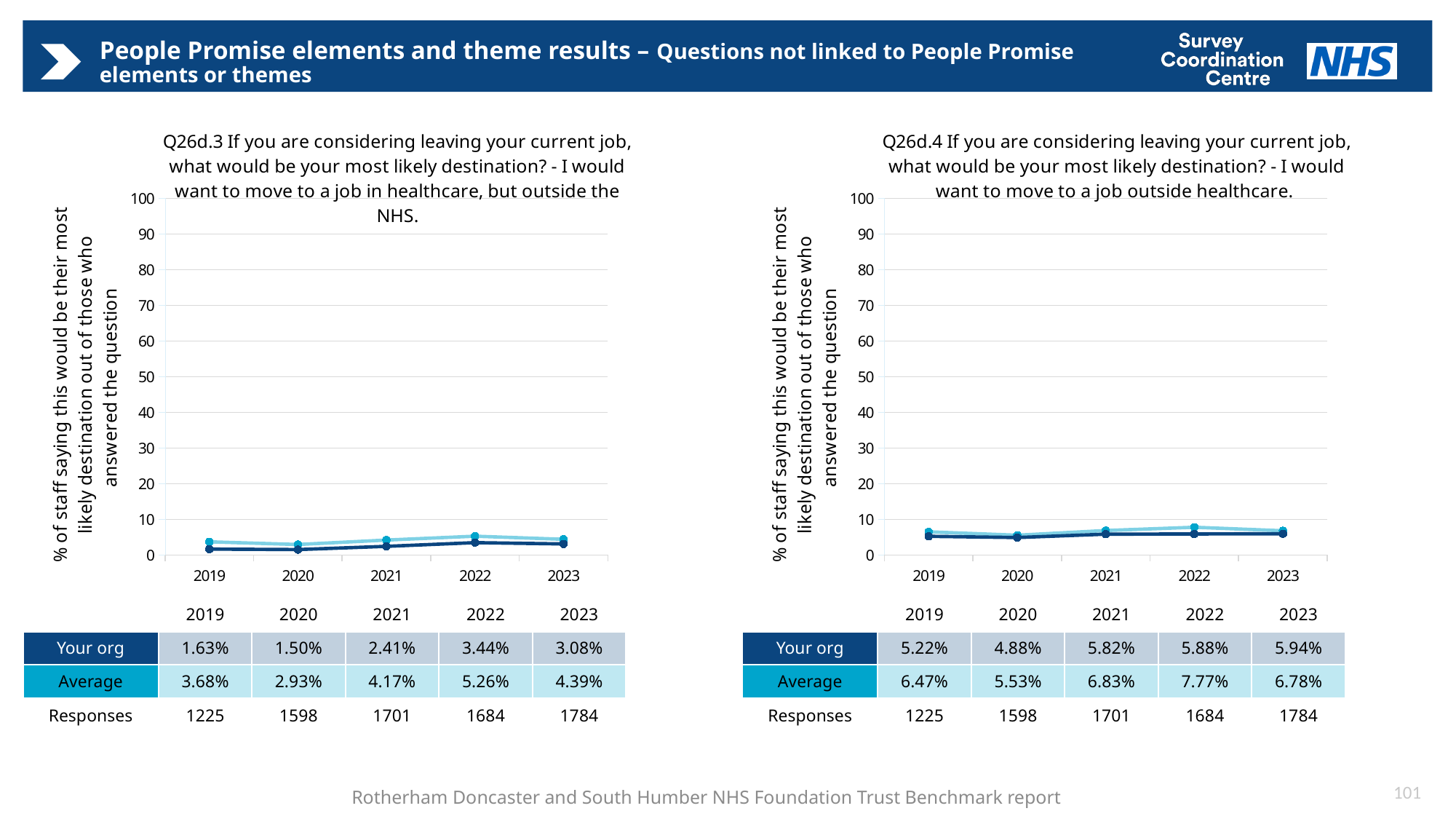
In the Q26d.4 chart (right), what is the Average value for 2020? 5.53% In the Q26d.3 chart (left), what is the Your org value for 2022? 3.44% How many years are plotted on the x axis of the Q26d.3 chart (left)? 5 In the Q26d.3 chart (left), how many responses were recorded for 2023? 1784 In the Q26d.4 chart (right), which year has the lowest Average value? 2020 What type of chart is the Q26d.4 chart (right)? Line chart In the Q26d.4 chart (right), what is the difference between the Average and Your org values in 2022? 1.89% In the Q26d.3 chart (left), what is the Average value for 2021? 4.17% In the Q26d.4 chart (right), which is larger in 2019: Your org or Average? Average In the Q26d.3 chart (left), what is the difference between the Average and Your org values in 2022? 1.82% In the Q26d.3 chart (left), which year has the highest Your org value? 2022 In the Q26d.4 chart (right), what is the Your org value for 2023? 5.94%